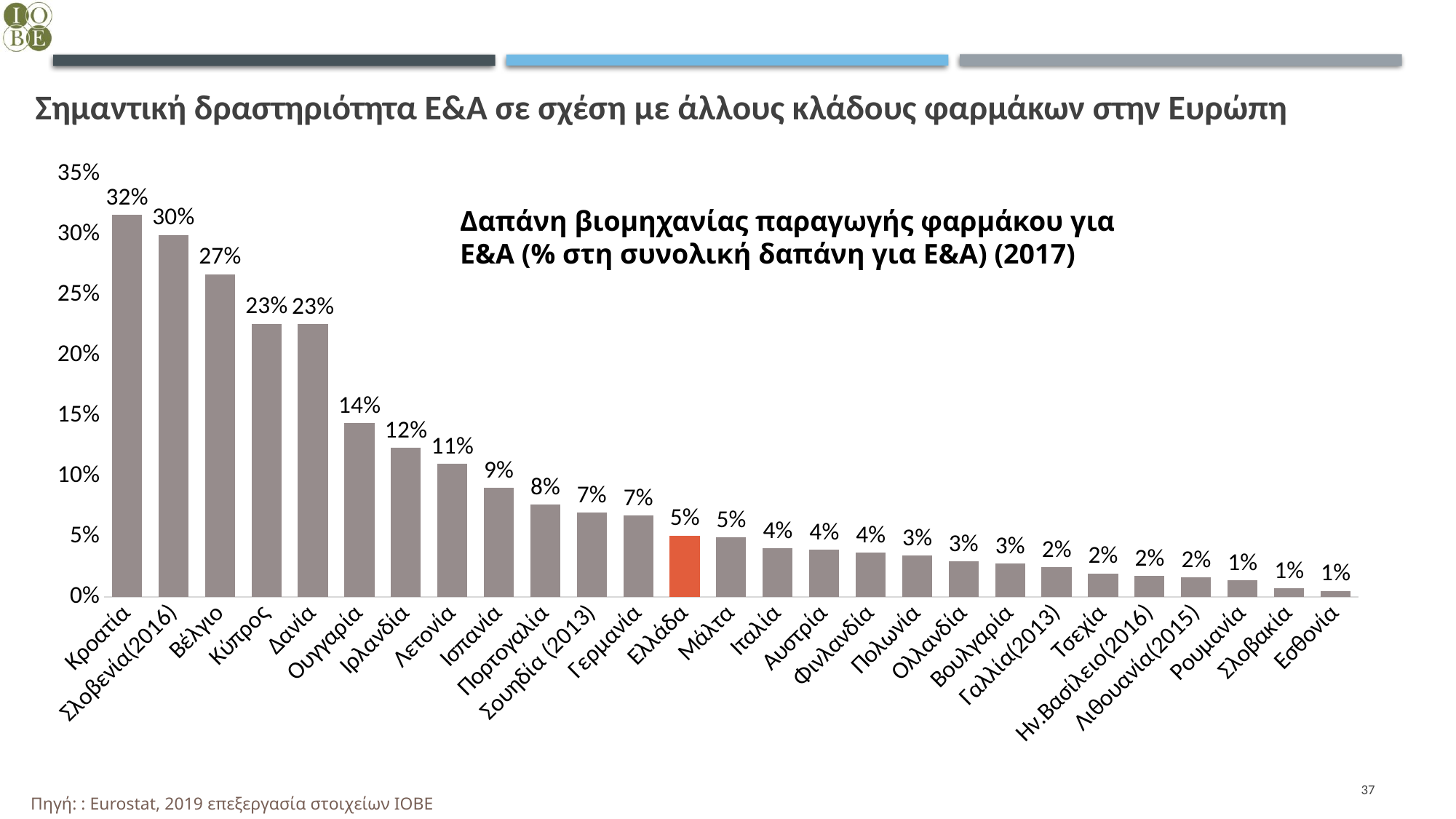
What kind of chart is shown on the slide? Bar chart How many countries are shown in the chart? 27 Is the value for Σλοβενία(2016) greater or less than 25%? greater What is the value for Κροατία? 32% Which is larger, the value for Λετονία or the value for Ισπανία? Λετονία What is the value for Ελλάδα? 5% Which country has the highest value? Κροατία What is the value for Γερμανία? 7% What is the difference between the values for Κροατία and Βέλγιο? 5% Which bar is highlighted in a different colour (orange) from the others? Ελλάδα What is the value for Ουγγαρία? 14% What is the difference between the values for Ελλάδα and Ιρλανδία? 7%